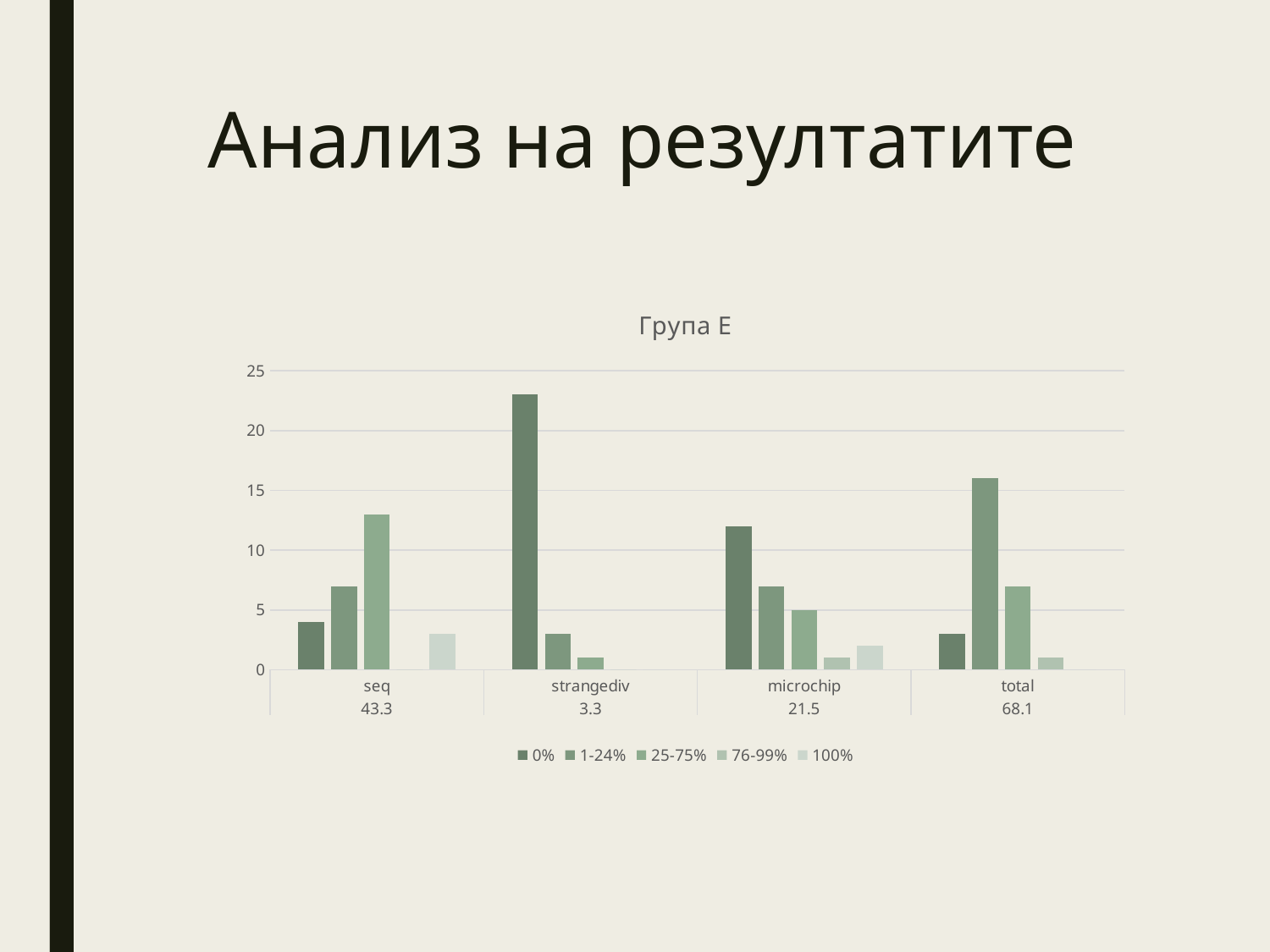
Is the 25-75% value for seq greater or less than 10? greater Is the 1-24% value for total greater or less than 15? greater What is the title of the chart? Група E Which category has the tallest 0% bar? strangediv Is the 0% value for strangediv greater or less than 20? greater Which is larger, the 25-75% value for seq or the 25-75% value for microchip? seq Which series has the tallest bar in the total category? 1-24% How many categories are shown on the x axis? 4 How many series does the legend list? 5 What number is printed under the seq category label? 43.3 What kind of chart is shown on the slide? bar chart